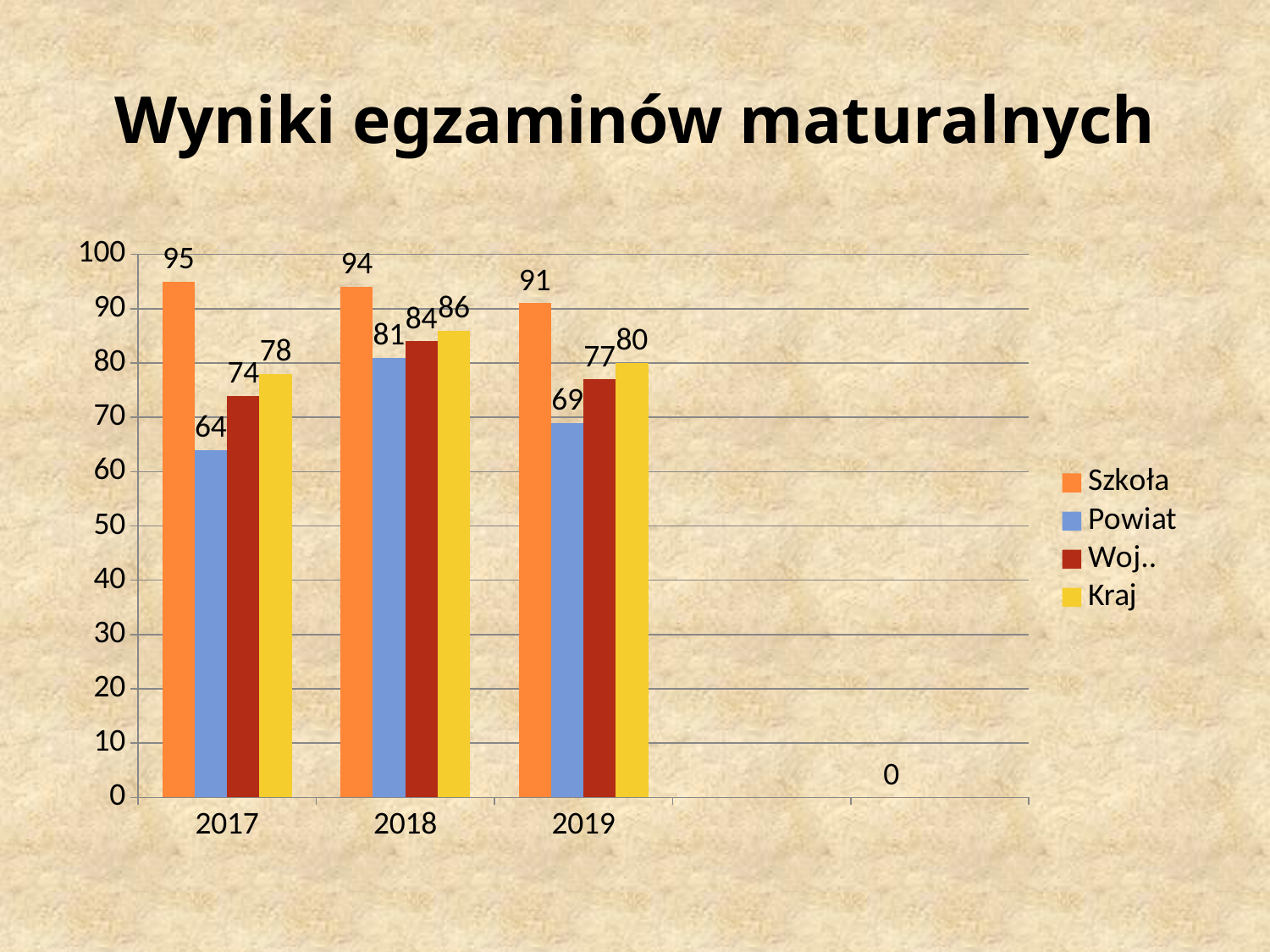
Which year has the highest value for Powiat? 2018 Which is larger in 2019, the value for Woj.. or the value for Kraj? Kraj What is the title of the chart? Wyniki egzaminów maturalnych Which series is shown in yellow? Kraj Do the Szkoła values rise or fall from 2017 to 2019? fall What is the value for Powiat in 2019? 69 What is the value for Szkoła in 2017? 95 What kind of chart is shown on the slide? bar chart How many series does the legend list? 4 What is the value for Kraj in 2018? 86 Which year has the lowest value for Szkoła? 2019 What is the difference between the Szkoła and Powiat values in 2017? 31